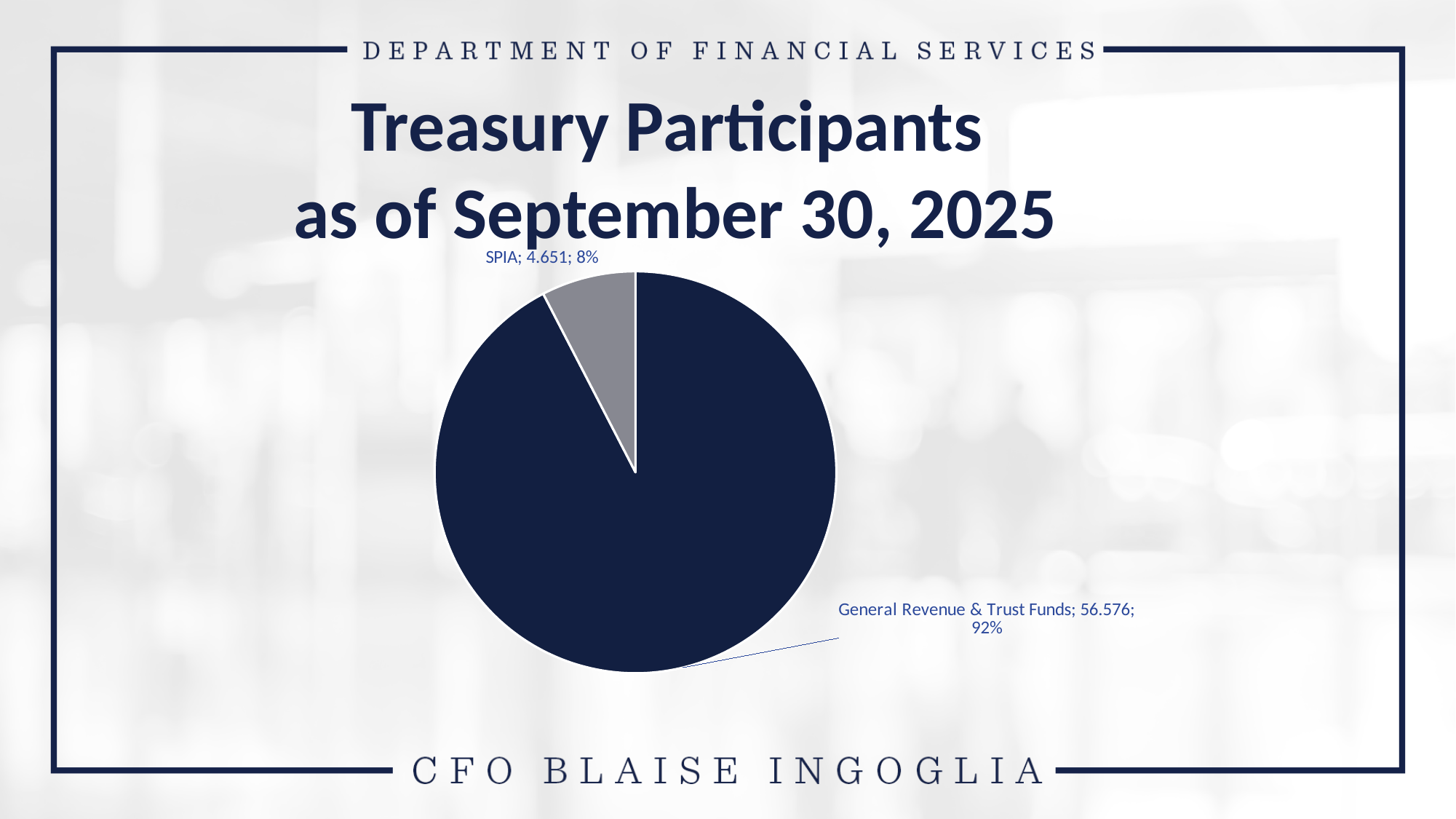
What share of the pie does SPIA represent? 8% What share of the pie does General Revenue & Trust Funds represent? 92% Which category has the smallest slice of the pie? SPIA Which is larger, the value for SPIA or the value for General Revenue & Trust Funds? General Revenue & Trust Funds What kind of chart is shown on the slide? pie chart What is the title of the slide containing the pie chart? Treasury Participants as of September 30, 2025 What is the value for SPIA? 4.651 How many slices does the pie chart have? 2 What is the difference between the value for General Revenue & Trust Funds and the value for SPIA? 51.925 Which category has the largest slice of the pie? General Revenue & Trust Funds What is the total of the two values shown in the pie chart? 61.227 What is the value for General Revenue & Trust Funds? 56.576